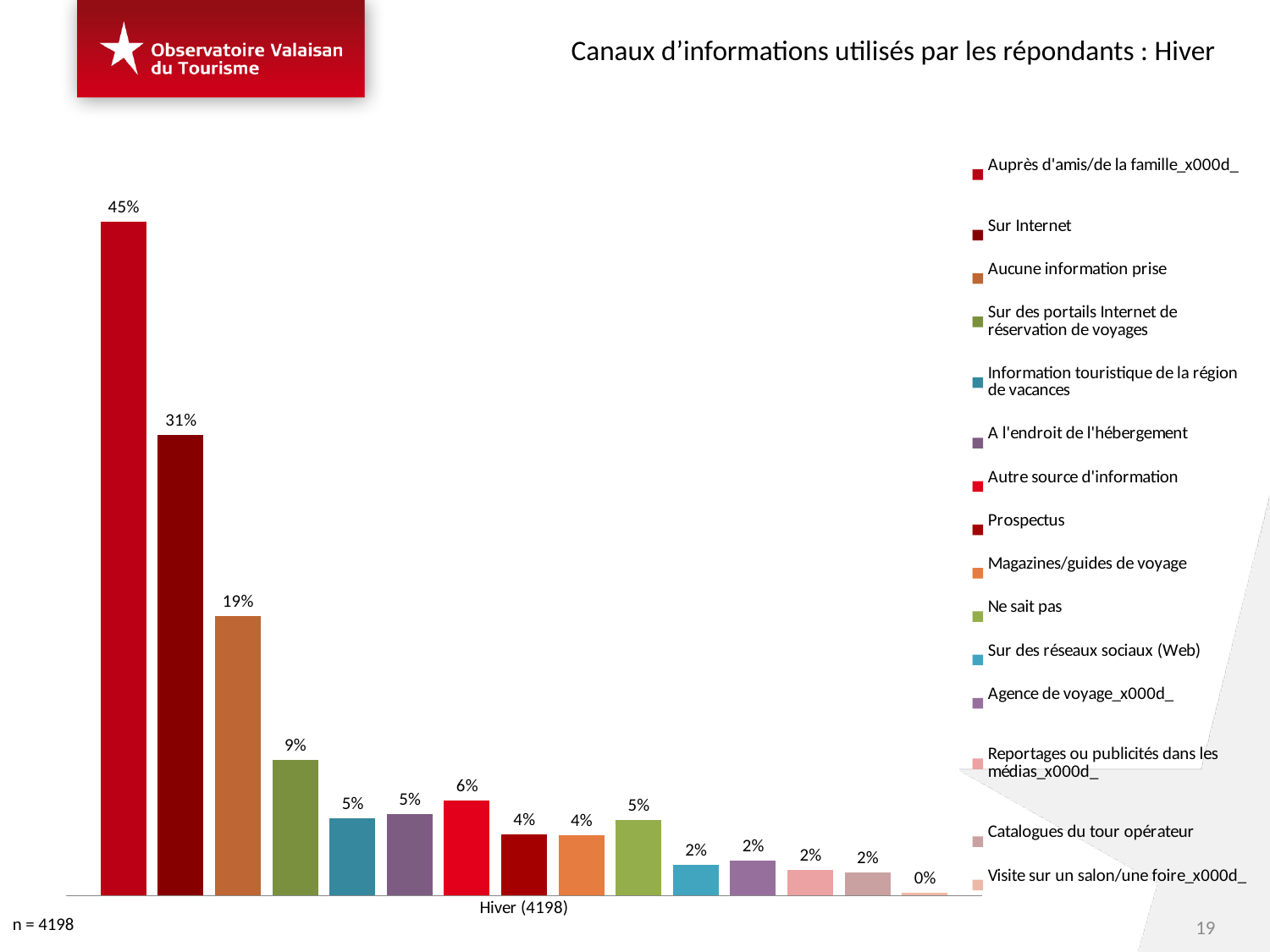
What is the difference between the values for 'Auprès d'amis/de la famille' and 'Sur Internet'? 14% What type of chart is shown on the slide? bar chart What is the title of the chart? Canaux d'informations utilisés par les répondants : Hiver What is the value for 'Aucune information prise'? 19% What is the value for 'Autre source d'information'? 6% What is the value for 'Sur des portails Internet de réservation de voyages'? 9% Which is larger, the value for 'Aucune information prise' or the value for 'Sur des portails Internet de réservation de voyages'? Aucune information prise What is the value for 'Sur Internet'? 31% How many series does the legend list? 15 What is the value for 'Auprès d'amis/de la famille'? 45% Which information channel has the lowest value? Visite sur un salon/une foire Which information channel has the highest value? Auprès d'amis/de la famille